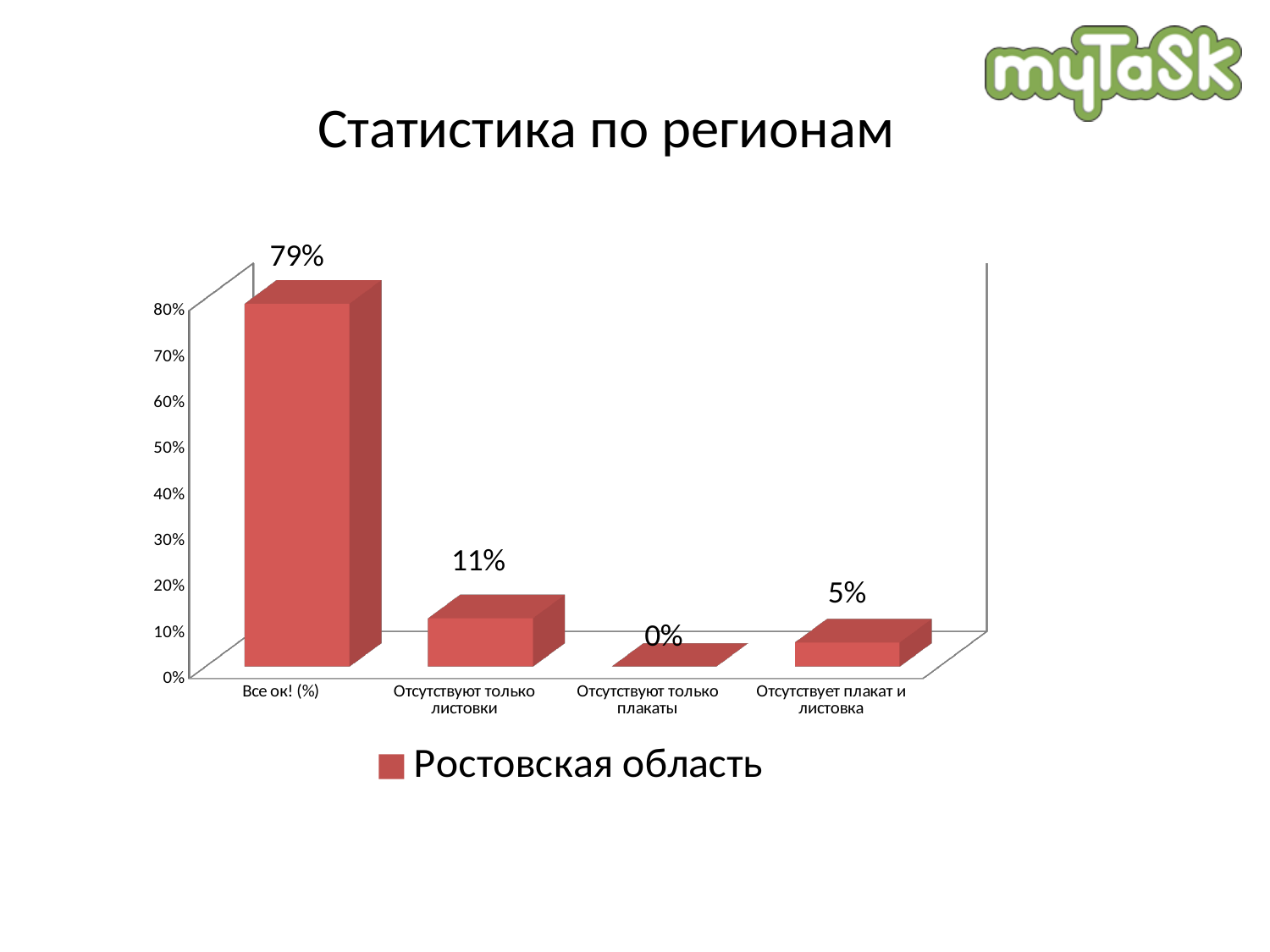
What is the value for "Отсутствуют только листовки"? 11% What is the value for "Отсутствует плакат и листовка"? 5% What kind of chart is shown on the slide? Bar chart What is the difference between the values for "Все ок! (%)" and "Отсутствуют только листовки"? 68% How many series does the legend list? 1 What is the value for "Отсутствуют только плакаты"? 0% What series name is shown in the legend? Ростовская область What is the value for "Все ок! (%)"? 79% Which category has the highest value? Все ок! (%) Which category has the lowest value? Отсутствуют только плакаты Which is larger: the value for "Отсутствуют только листовки" or for "Отсутствует плакат и листовка"? Отсутствуют только листовки How many categories are shown on the x axis? 4